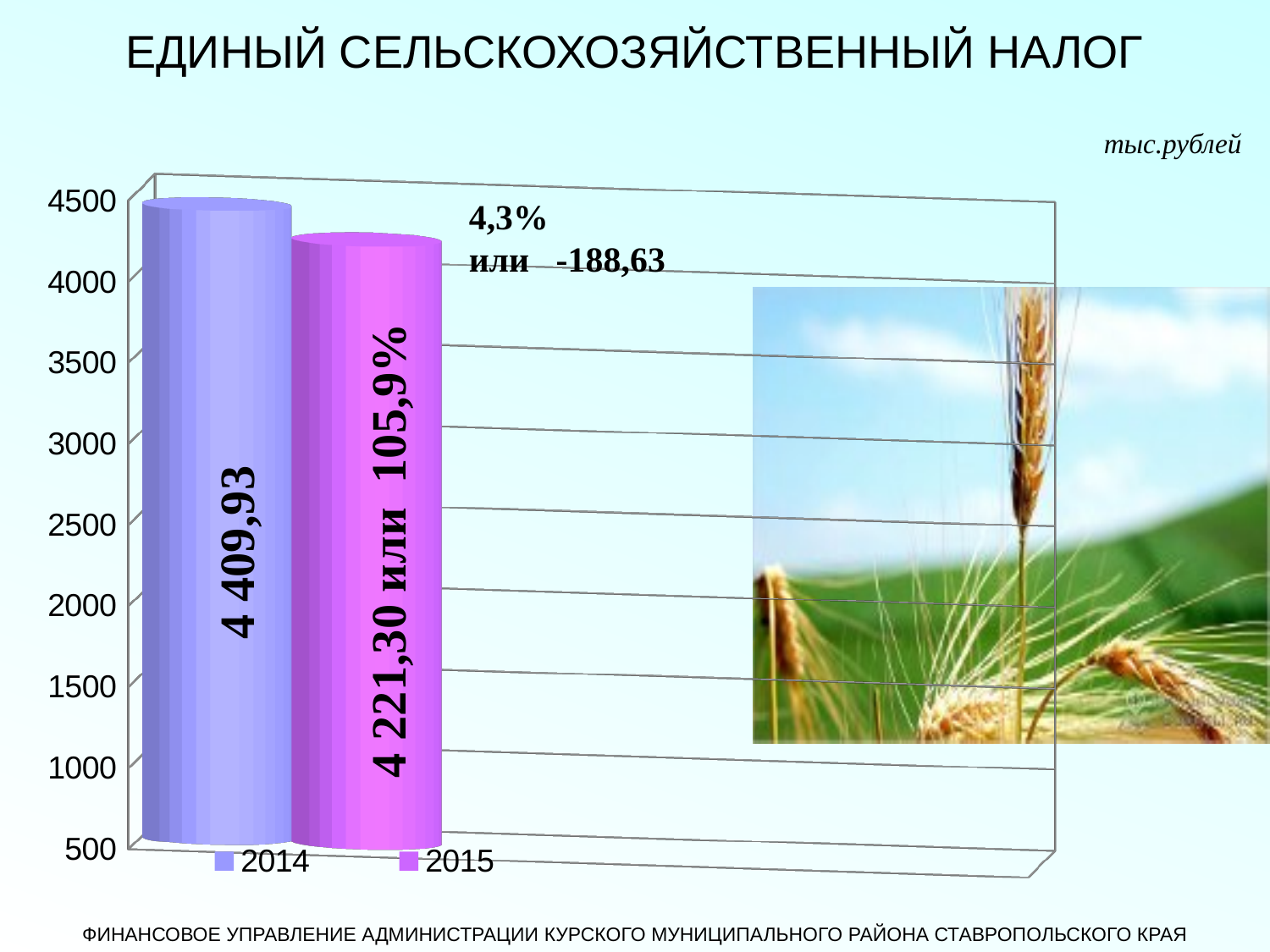
How many bars are plotted on the chart? 2 Is the value for 2015 greater or less than 4000? greater What is the value for 2015? 4 221,30 Which year has the lowest value? 2015 What is the value for 2014? 4 409,93 What unit of measurement is indicated for the chart? тыс.рублей What kind of chart is shown on the slide? bar chart Which year has the higher value, 2014 or 2015? 2014 What is the difference between the 2014 and 2015 values? 188,63 How many entries does the legend list? 2 Is the value for 2014 greater or less than 4500? less Do the values rise or fall from 2014 to 2015? fall